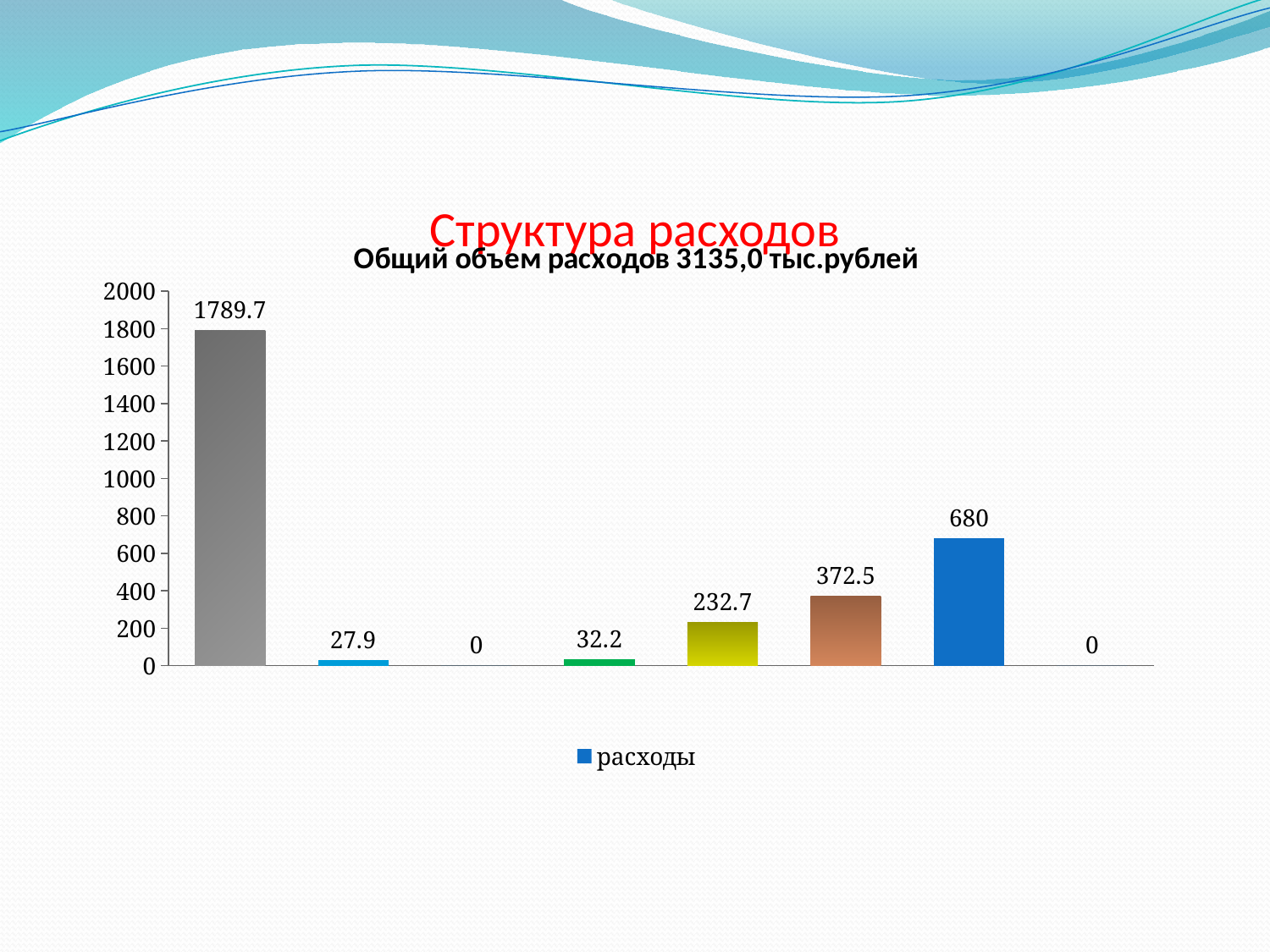
What is the value shown on the blue bar, the seventh bar from the left? 680 What is the title printed above the chart? Общий объем расходов 3135,0 тыс.рублей How many series does the legend list? 1 What is the value shown on the brown bar, the sixth bar from the left? 372.5 What is the difference between the value of the first (grey) bar and the blue bar (680)? 1109.7 Which bar has the highest value in the chart? the first (grey) bar, 1789.7 What is the value shown on the yellow bar, the fifth bar from the left? 232.7 Which is larger: the value of the brown bar (372.5) or the yellow bar (232.7)? the brown bar, 372.5 How many bars (categories) are plotted in the chart, including those with a value of 0? 8 What is the value shown on the first (grey) bar of the chart? 1789.7 What is the value shown on the green bar, the fourth bar from the left? 32.2 What kind of chart is shown on the slide? bar chart